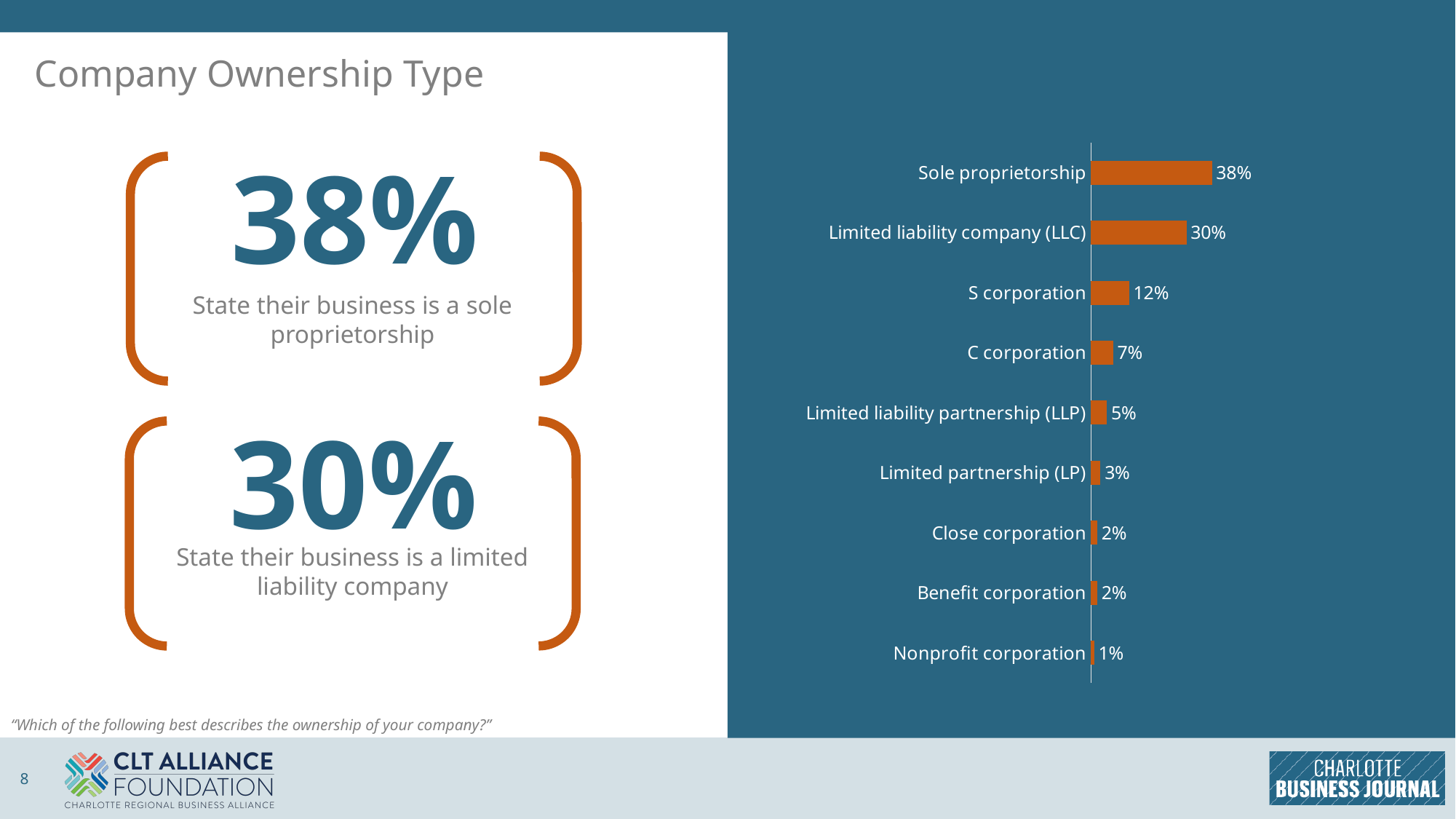
What is the title of the slide containing the chart? Company Ownership Type Which ownership type has the highest percentage? Sole proprietorship What is the value shown for S corporation? 12% What is the difference between the percentages for Sole proprietorship and Limited liability company (LLC)? 8% What is the value shown for Nonprofit corporation? 1% What is the difference between the percentages for S corporation and C corporation? 5% What is the value shown for Limited liability partnership (LLP)? 5% What percentage of respondents state their business is a sole proprietorship? 38% Which is larger, the value for C corporation or the value for Limited partnership (LP)? C corporation Which ownership type has the lowest percentage? Nonprofit corporation What kind of chart is shown on the slide? Bar chart How many ownership types are shown in the chart? 9